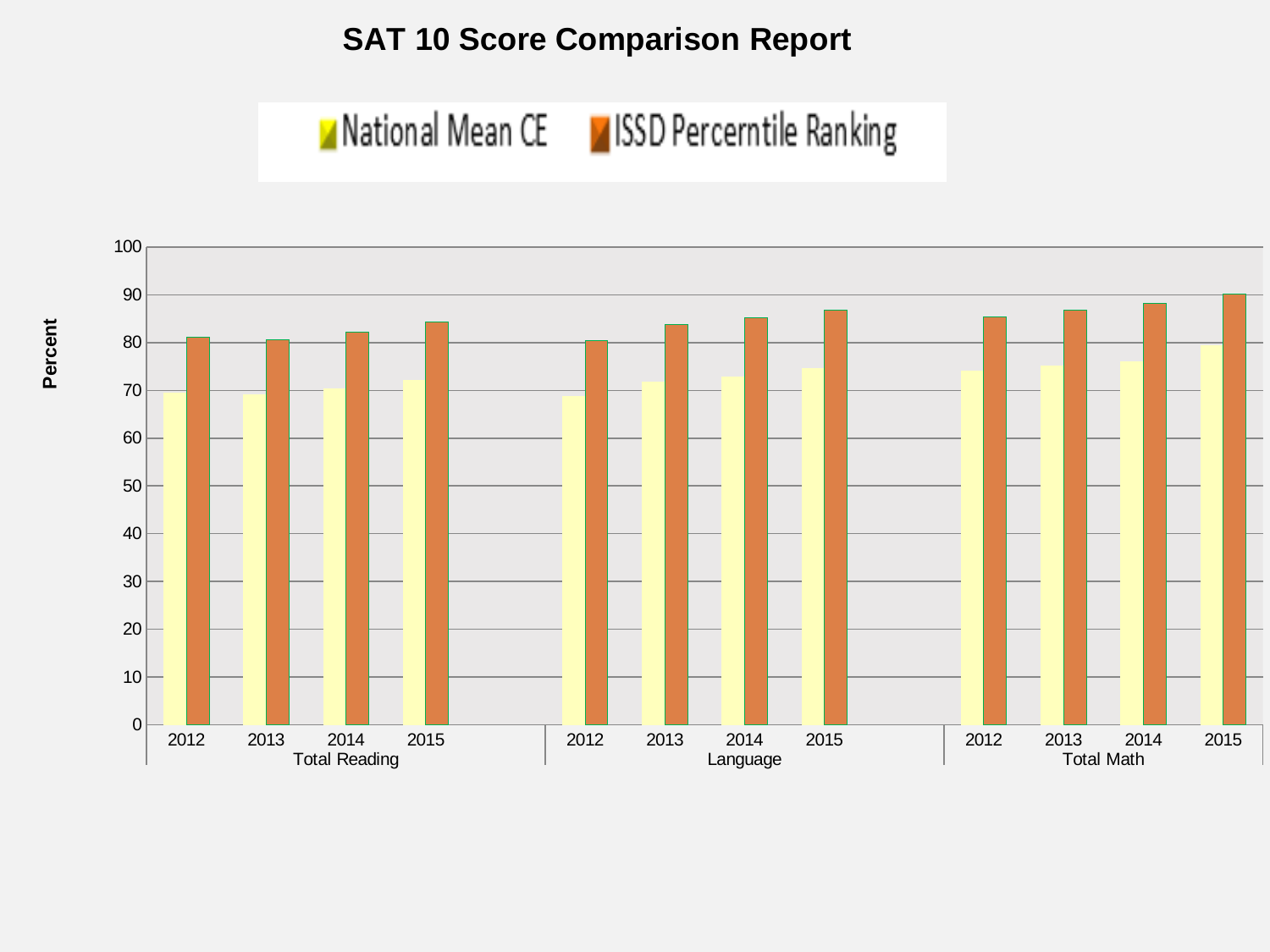
Which subject and year has the highest ISSD Percerntile Ranking bar? Total Math 2015 Within the Total Math group, do the ISSD Percerntile Ranking values rise or fall from 2012 to 2015? rise Is the National Mean CE value for Total Math in 2015 greater or less than 70? greater For Total Reading in 2015, which is larger: National Mean CE or ISSD Percerntile Ranking? ISSD Percerntile Ranking How many subject groups are shown along the x axis? 3 How many series does the legend list? 2 What kind of chart is shown on the slide? bar chart Is the ISSD Percerntile Ranking value for Total Math in 2015 greater or less than 80? greater What are the two series named in the legend? National Mean CE and ISSD Percerntile Ranking What is the label of the y axis? Percent How many years are shown within each subject group? 4 Is the National Mean CE value for Language in 2012 greater or less than 70? less